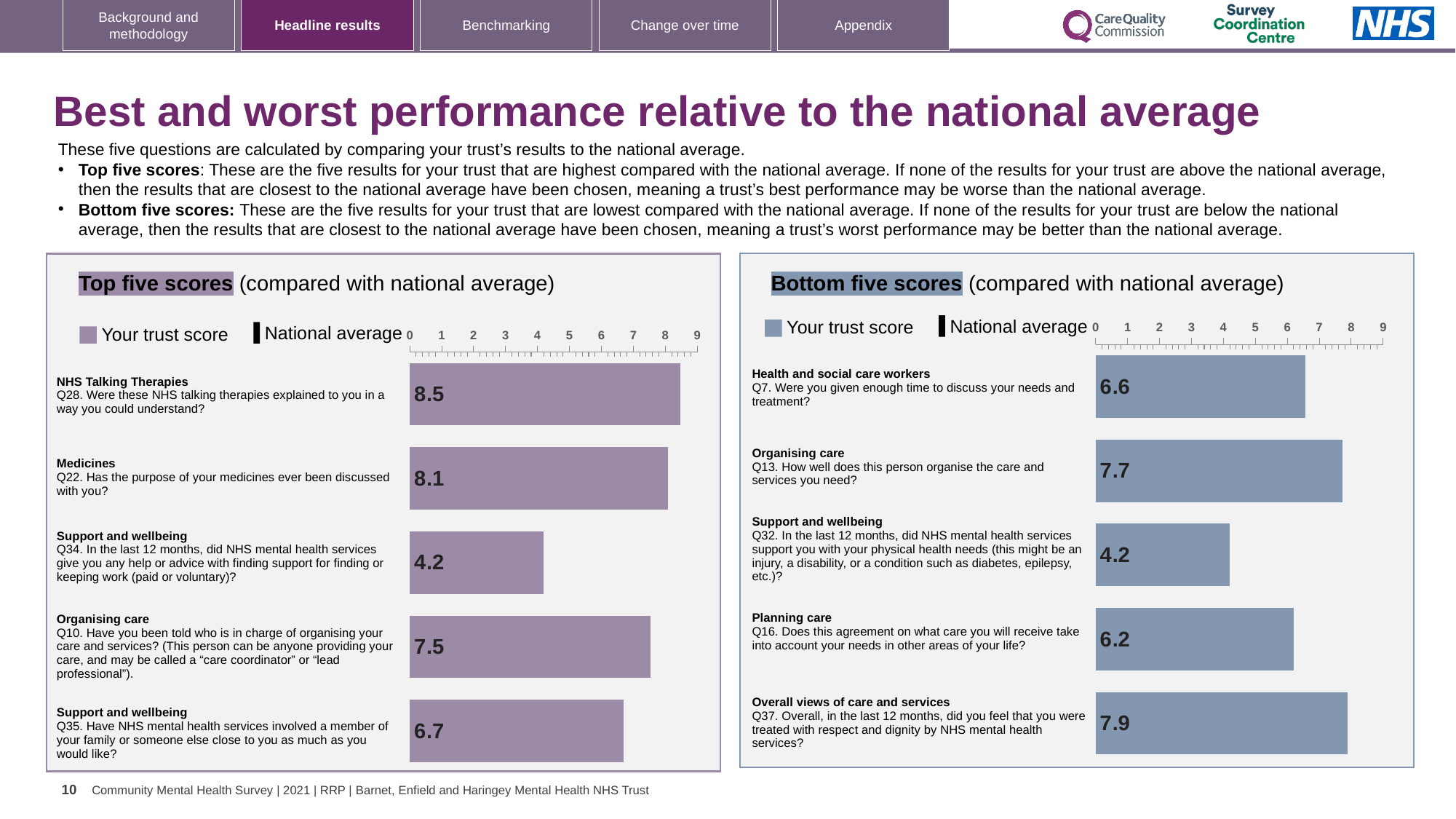
How many questions are shown in the 'Top five scores' chart? 5 How many entries does the legend of the 'Top five scores' chart list? 2 In the 'Bottom five scores' chart, which question has the highest trust score? Q37 (Overall views of care and services) In the 'Bottom five scores' chart, what is the trust score for Q16 (Planning care)? 6.2 In the 'Top five scores' chart, what is the difference between the trust scores for Q28 and Q22? 0.4 In the 'Top five scores' chart, which question has the lowest trust score? Q34 (Support and wellbeing) In the 'Top five scores' chart, what is the trust score for Q28 (NHS Talking Therapies)? 8.5 What kind of chart is the 'Bottom five scores' chart? Bar chart In the 'Bottom five scores' chart, which has the larger trust score, Q7 or Q16? Q7 In the 'Top five scores' chart, what is the trust score for Q10 (Organising care)? 7.5 In the 'Bottom five scores' chart, what is the difference between the trust scores for Q13 and Q7? 1.1 In the 'Bottom five scores' chart, what is the trust score for Q37 (Overall views of care and services)? 7.9